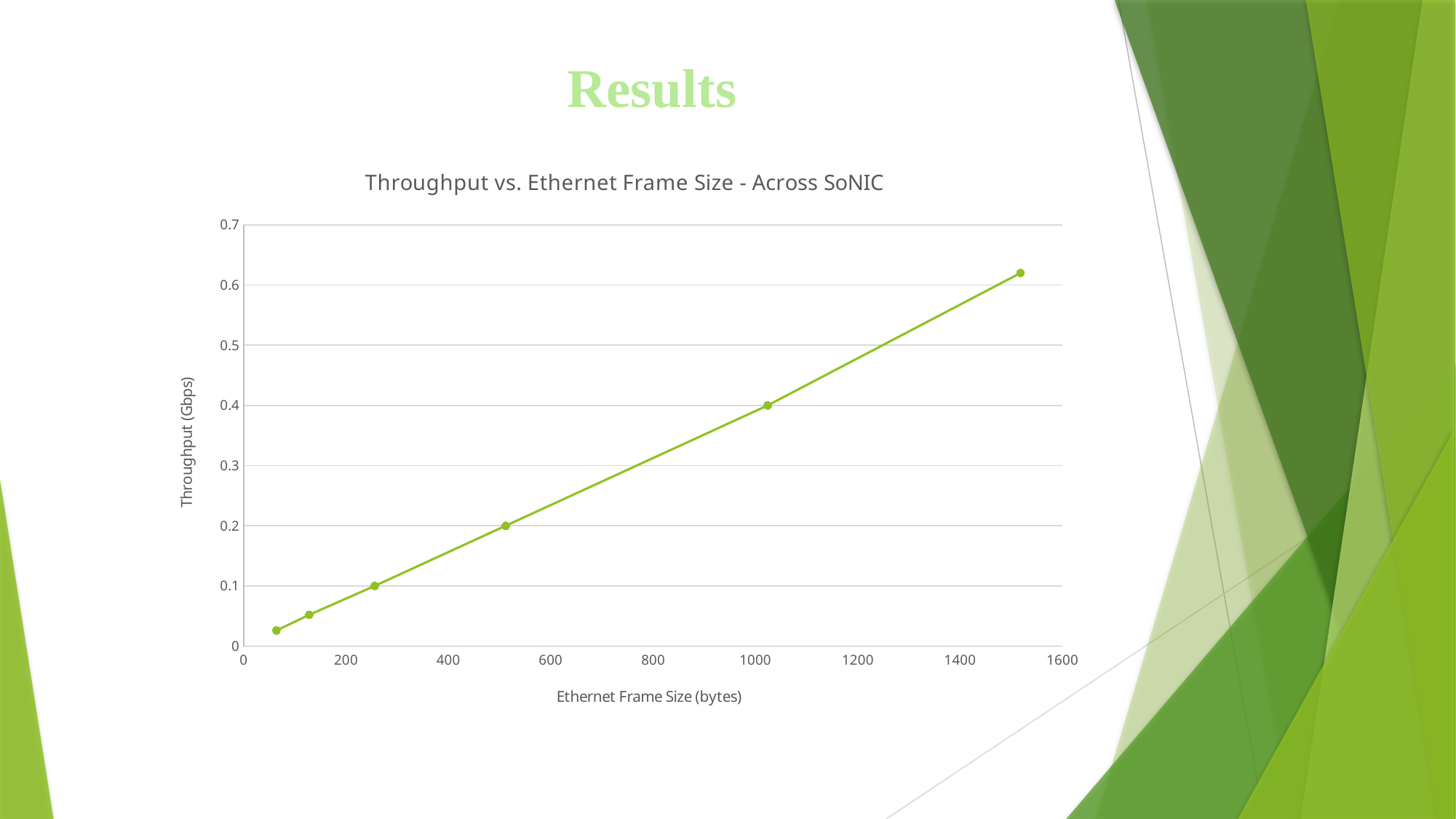
What type of chart is shown on the slide? line chart Does throughput rise or fall as Ethernet frame size increases? rises What is the title of the chart? Throughput vs. Ethernet Frame Size - Across SoNIC Is the throughput at the point near 1000 bytes greater or less than 0.3? greater Is the throughput at the smallest frame size (leftmost point) greater or less than 0.1? less What is the maximum value shown on the y axis? 0.7 Which point has the highest throughput: the one near 1000 bytes or the one near 1500 bytes? the one near 1500 bytes Is the throughput at the largest frame size (rightmost point) greater or less than 0.6? greater How many data points are plotted on the line? 6 What is the label of the y axis? Throughput (Gbps)